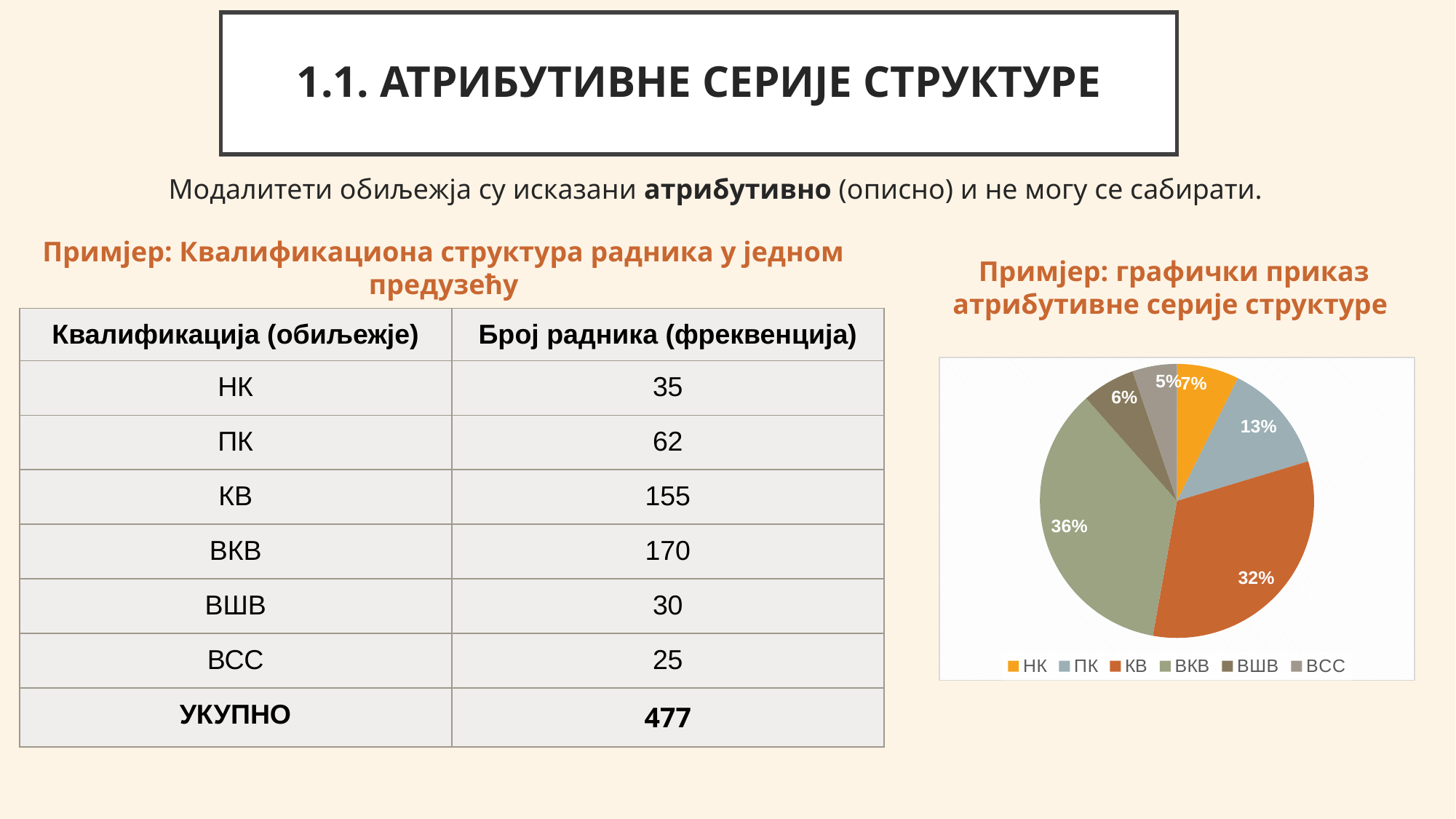
Which category has the largest slice of the pie? ВКВ What kind of chart is shown on the slide? pie chart Which category has the smallest slice of the pie? ВСС What share of the pie does the КВ slice represent? 32% By how many percentage points does the ВКВ slice exceed the КВ slice? 4 What share of the pie does the ВКВ slice represent? 36% What share of the pie does the ВШВ slice represent? 6% Which slice is larger, ПК or КВ? КВ How many slices does the pie chart have? 6 Which category is shown in orange-yellow in the pie chart legend? НК